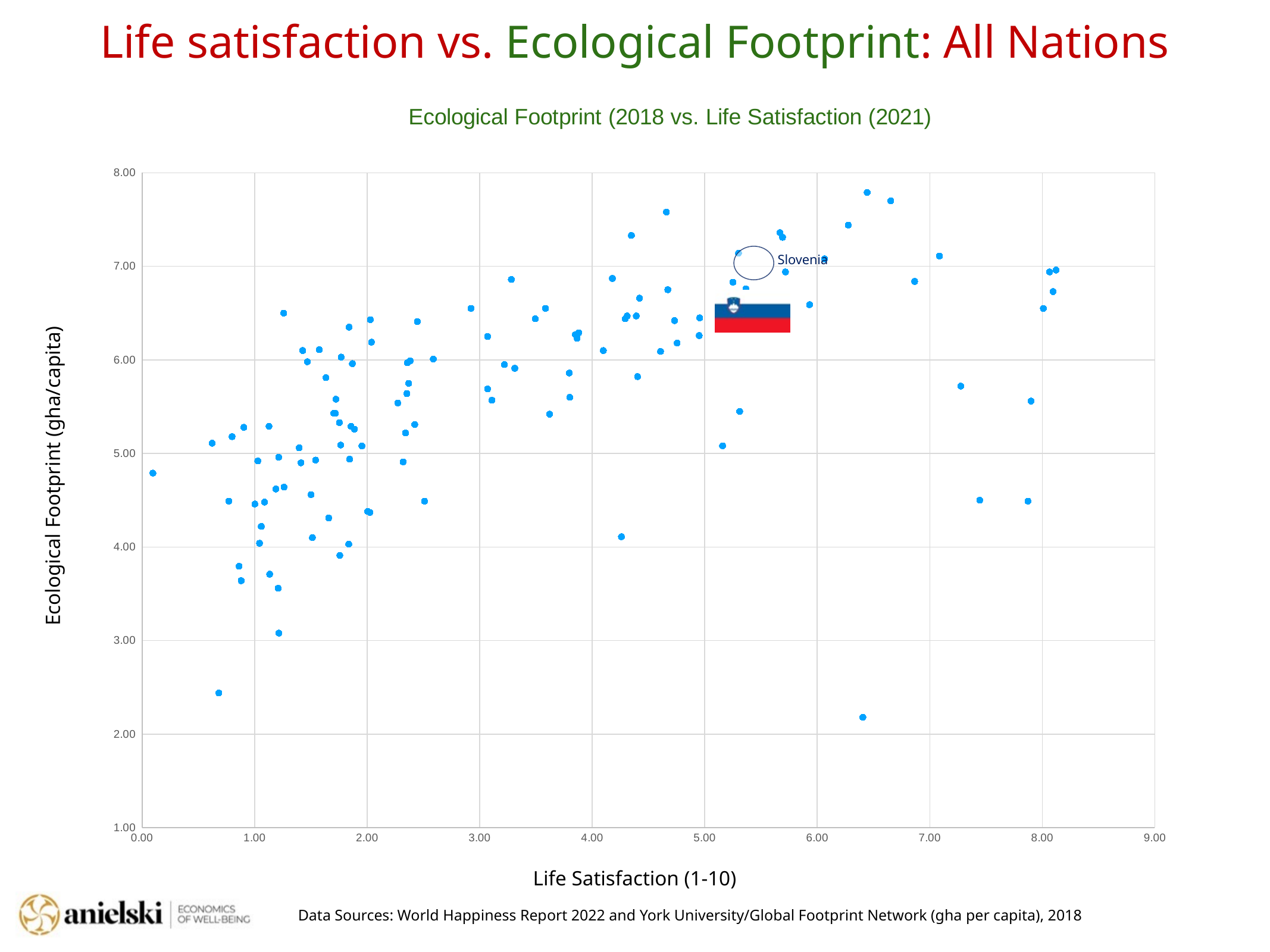
Is the life satisfaction value for Slovenia greater or less than 5.00? greater Do ecological footprint values generally rise or fall as life satisfaction increases along the x axis? rise What is the title printed above the chart? Ecological Footprint (2018 vs. Life Satisfaction (2021) What is the highest tick value shown on the x axis? 9.00 What is the lowest tick value shown on the y axis? 1.00 Is the ecological footprint value for Slovenia greater or less than 6.00? greater What kind of chart is shown on the slide? Scatter plot What is the label of the x axis? Life Satisfaction (1-10) Is the ecological footprint value for Slovenia greater or less than 8.00? less What is the highest tick value shown on the y axis? 8.00 Which nation is labelled and circled on the chart? Slovenia